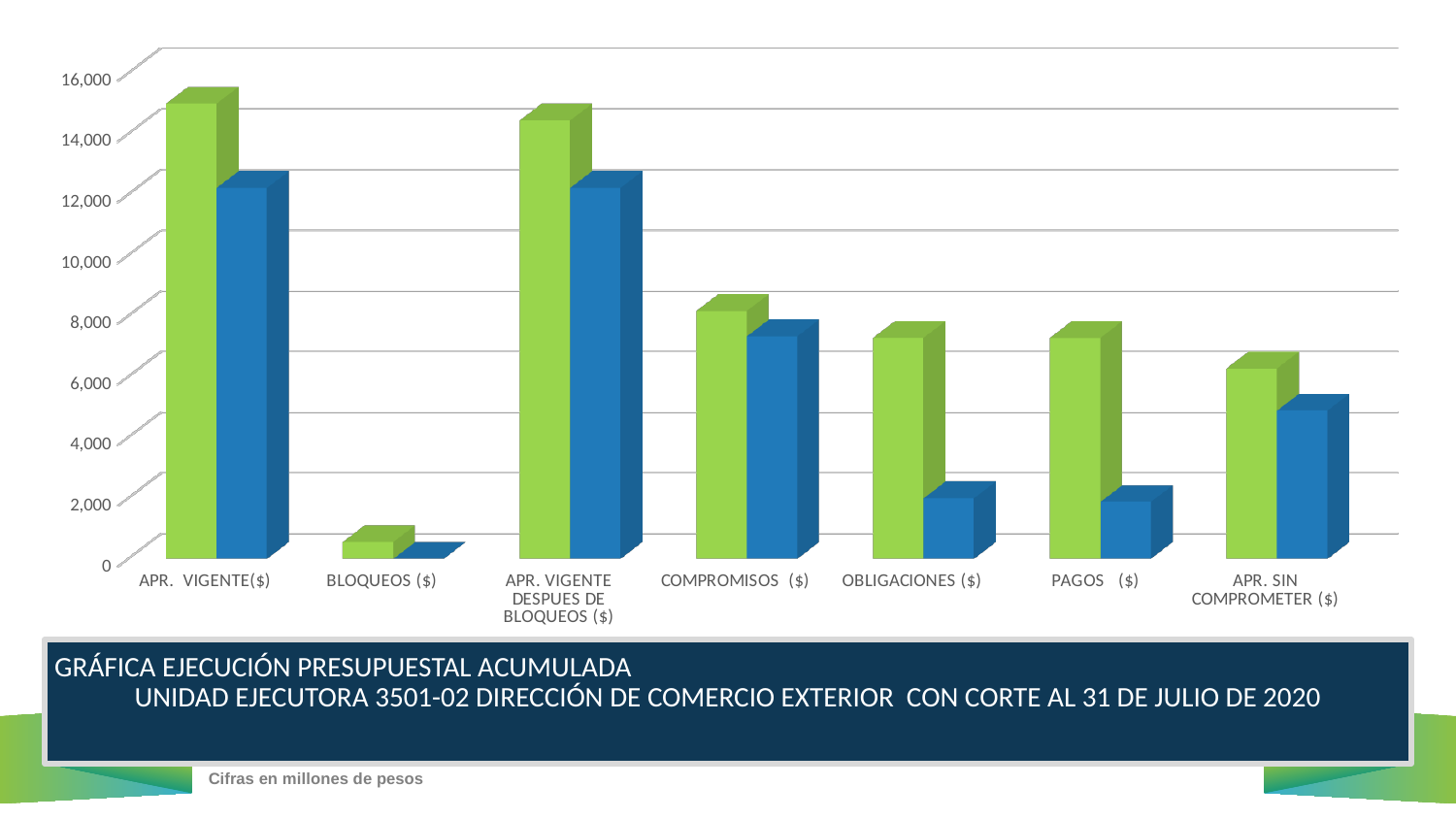
What is the first line of the chart's title shown in the blue box below the chart? GRÁFICA EJECUCIÓN PRESUPUESTAL ACUMULADA Which blue bar is taller: PAGOS ($) or APR. SIN COMPROMETER ($)? APR. SIN COMPROMETER ($) Which category has the tallest green bar? APR. VIGENTE($) Which green bar is taller: COMPROMISOS ($) or APR. SIN COMPROMETER ($)? COMPROMISOS ($) Is the blue bar for OBLIGACIONES ($) greater or less than 4,000? less What kind of chart is shown on the slide? bar chart How many categories are shown on the x axis of the chart? 7 Is the green bar for BLOQUEOS ($) greater or less than 2,000? less According to the note at the bottom of the slide, in what units are the figures expressed? Cifras en millones de pesos Is the blue bar for APR. VIGENTE DESPUES DE BLOQUEOS ($) greater or less than 10,000? greater Which category has the shortest green bar? BLOQUEOS ($)